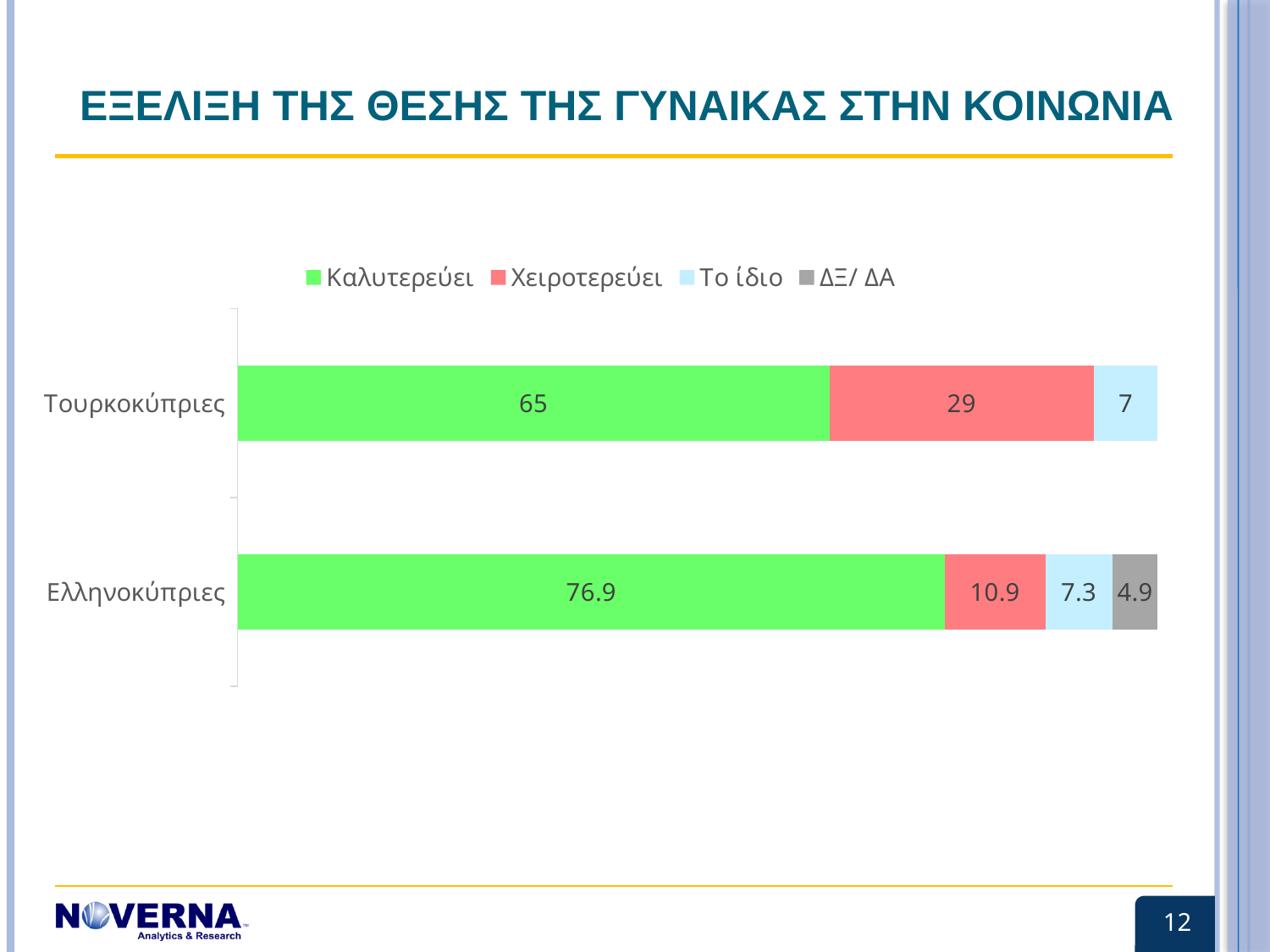
What is the value of Χειροτερεύει for Ελληνοκύπριες? 10.9 How many categories (groups) are shown on the chart? 2 What is the value of Καλυτερεύει for Τουρκοκύπριες? 65 What kind of chart is shown on the slide? Stacked bar chart What is the difference between the Χειροτερεύει values for Τουρκοκύπριες and Ελληνοκύπριες? 18.1 How many series does the legend list? 4 What is the difference between the Καλυτερεύει values for Ελληνοκύπριες and Τουρκοκύπριες? 11.9 What is the value of Το ίδιο for Τουρκοκύπριες? 7 What is the value of ΔΞ/ ΔΑ for Ελληνοκύπριες? 4.9 Which series is shown in green in the legend? Καλυτερεύει What is the total of the stacked bar for Ελληνοκύπριες? 100 Which group has the higher value for Καλυτερεύει, Τουρκοκύπριες or Ελληνοκύπριες? Ελληνοκύπριες